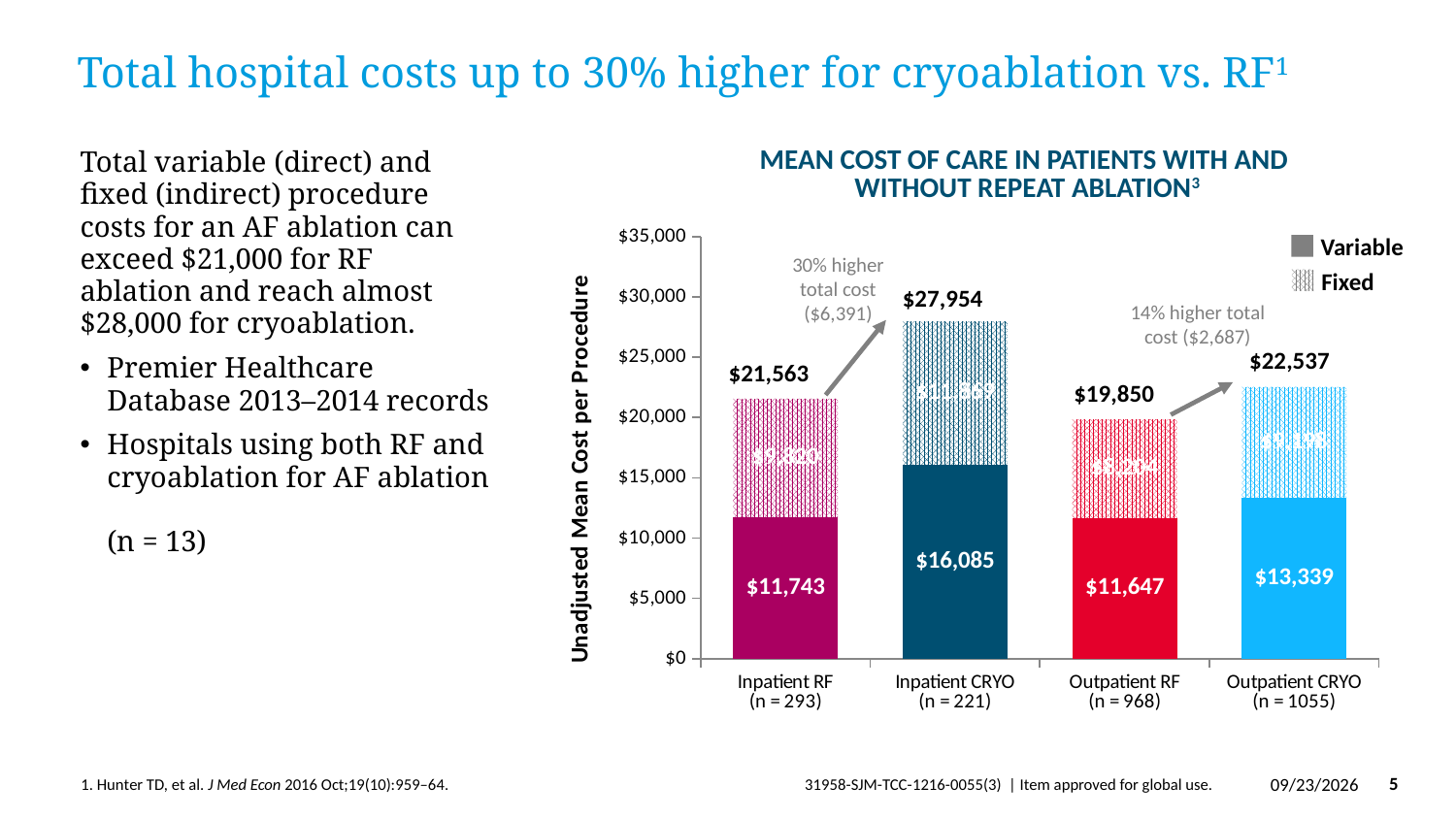
How much higher is the total cost for Outpatient CRYO than for Outpatient RF? $2,687 What is the total mean cost per procedure for Inpatient CRYO? $27,954 Which category has the highest total mean cost per procedure? Inpatient CRYO Is the total cost for Inpatient CRYO greater or less than $25,000? greater Which category has the lowest total mean cost per procedure? Outpatient RF What kind of chart is shown on the slide? Stacked bar chart What is the title of the y axis of the chart? Unadjusted Mean Cost per Procedure How many series does the chart legend list? 2 What is the Variable cost for Inpatient RF? $11,743 How much higher is the total cost for Inpatient CRYO than for Inpatient RF? $6,391 How many procedure categories are shown on the x axis of the chart? 4 What is the Variable cost for Outpatient CRYO? $13,339